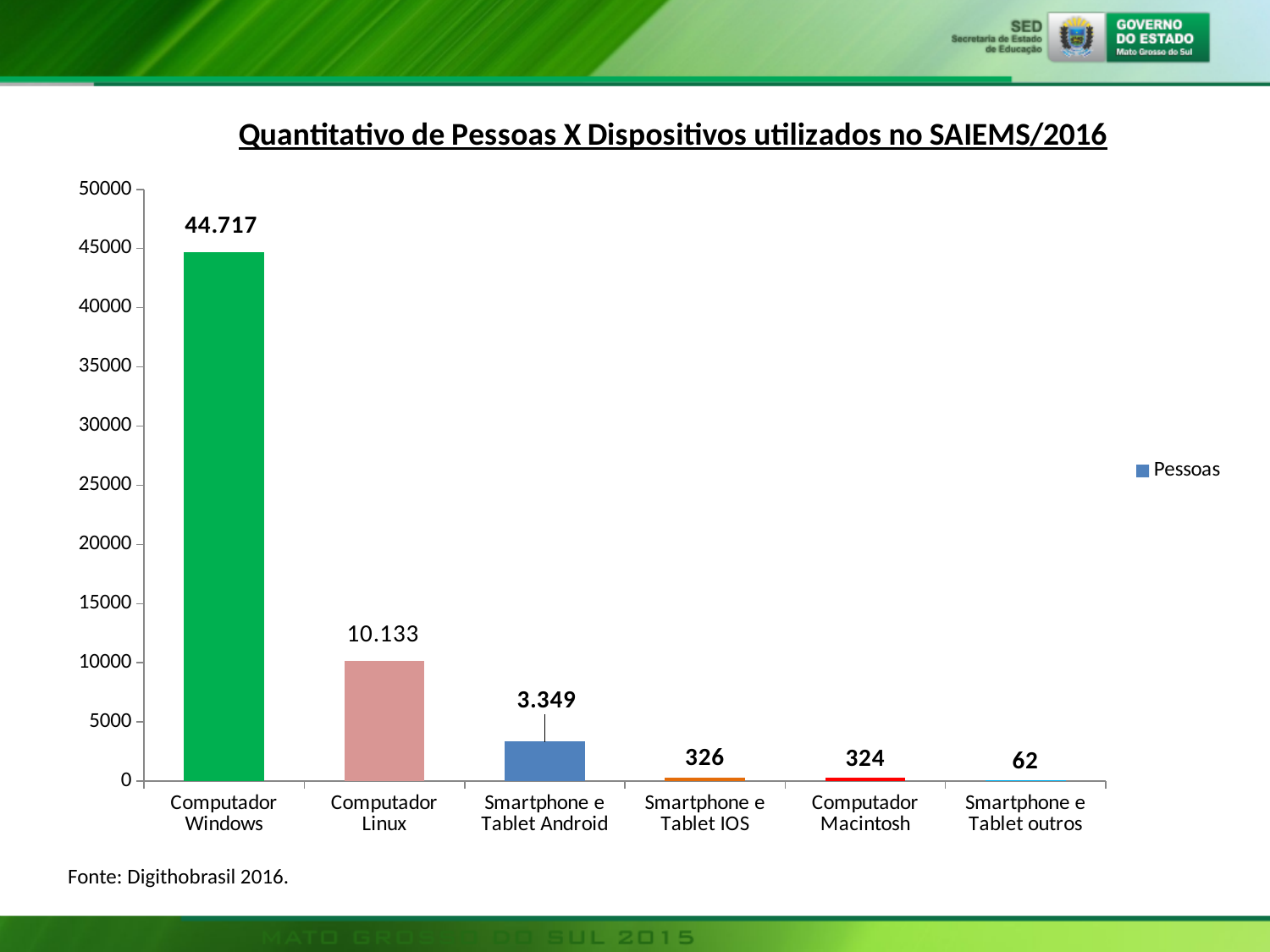
What kind of chart is shown on the slide? bar chart Which category has the lowest value? Smartphone e Tablet outros How many categories are shown on the x axis? 6 Which category has the highest value? Computador Windows What is the value for Smartphone e Tablet outros? 62 What is the difference between the values for Computador Windows and Computador Linux? 34.584 What is the value for Smartphone e Tablet Android? 3.349 What is the value for Computador Linux? 10.133 Which is larger, the value for Computador Linux or the value for Smartphone e Tablet Android? Computador Linux What is the value for Computador Windows? 44.717 What series name does the legend list? Pessoas Is the value for Computador Linux greater or less than 15000? less